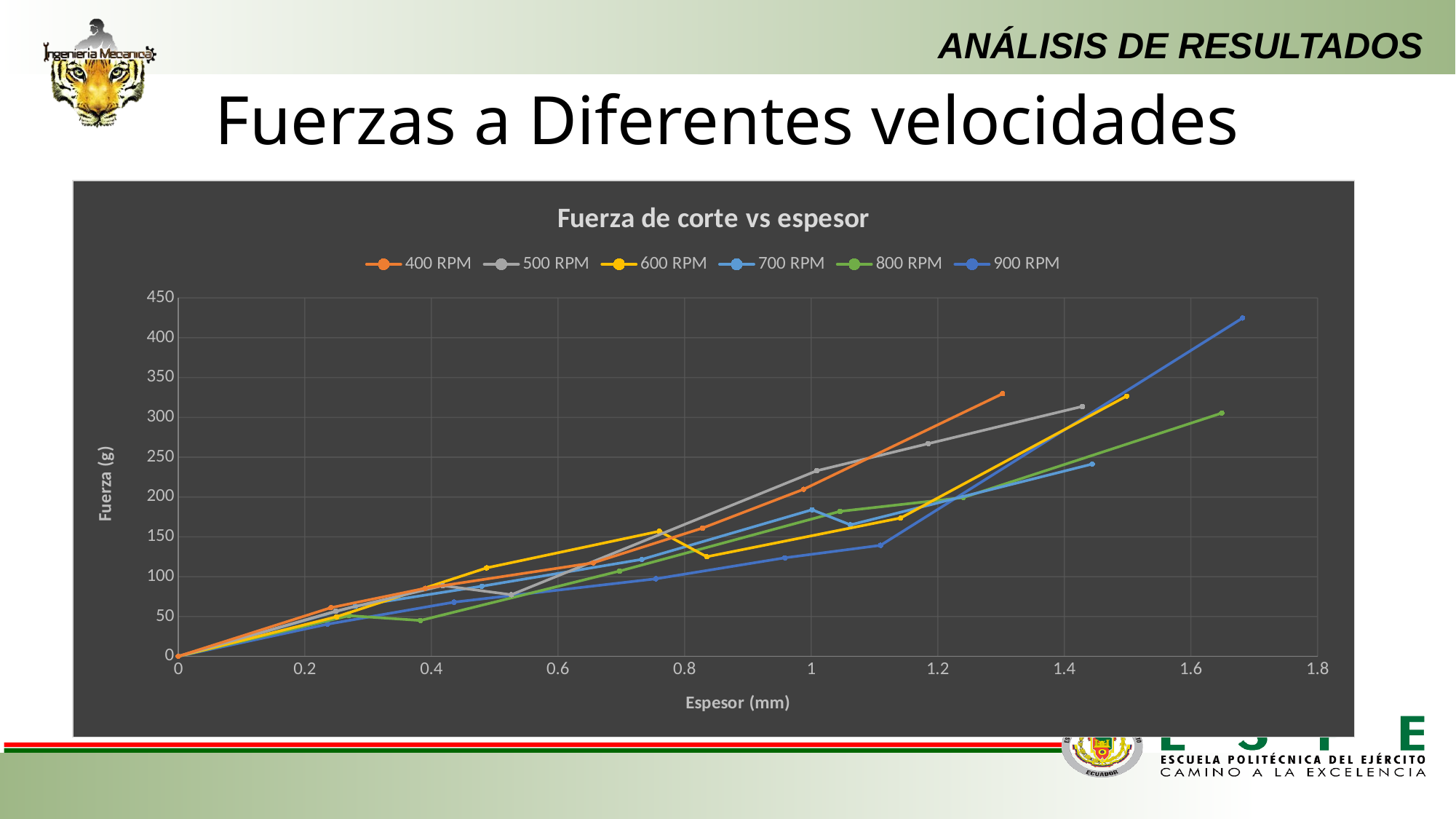
Which series reaches the highest force value on the chart? 900 RPM What kind of chart is shown on the slide? line chart Is the highest value of the 900 RPM series greater or less than 400? greater Do the force values generally rise or fall as the espesor increases? rise What is the label of the vertical axis of the chart? Fuerza (g) Which series has the lowest force at its final (rightmost) point? 700 RPM What is the title of the chart? Fuerza de corte vs espesor Which series reaches a higher force at its final point, 400 RPM or 700 RPM? 400 RPM Is the final value of the 400 RPM series greater or less than 300? greater How many series does the legend of the chart list? 6 Is the value of the 500 RPM series at an espesor of 1 mm greater or less than 200? greater